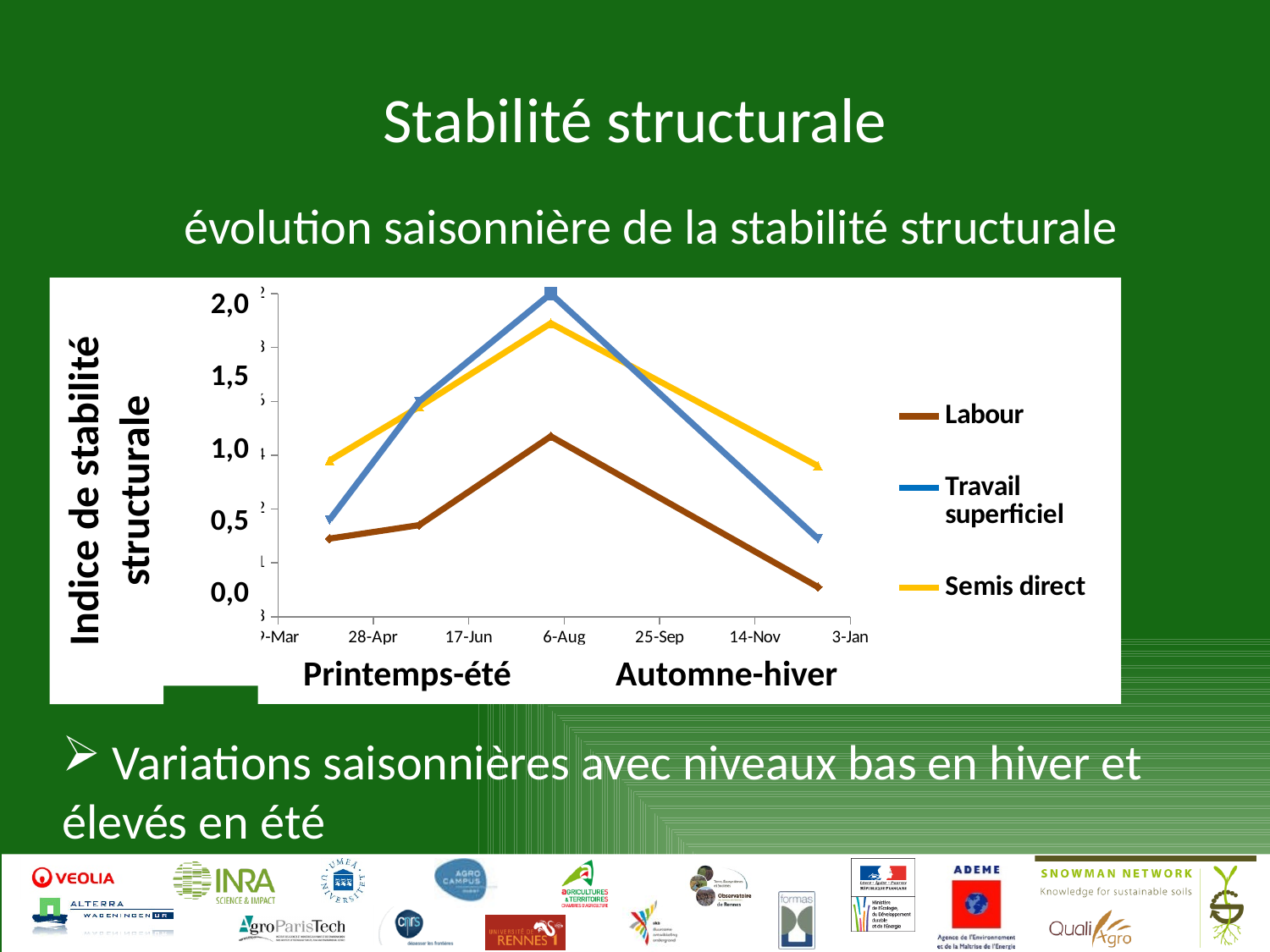
Which series are listed in the legend? Labour, Travail superficiel, Semis direct At the 6-Aug peak, which is higher: Travail superficiel or Labour? Travail superficiel How many series does the legend list? 3 Is the peak value for Travail superficiel around 6-Aug greater or less than 1,5? greater What is the title of the vertical axis? Indice de stabilité structurale At the last point on the right, which is higher: Semis direct or Labour? Semis direct Do the values for all three series rise or fall between 6-Aug and the last point on the right? fall Is the peak value for Labour around 6-Aug greater or less than 1,0? greater Which series has the lowest value at the last point on the right of the chart? Labour What kind of chart is shown on the slide? line chart Which series reaches the highest value on the chart? Travail superficiel Is the value for Labour at the last point on the right greater or less than 0,5? less